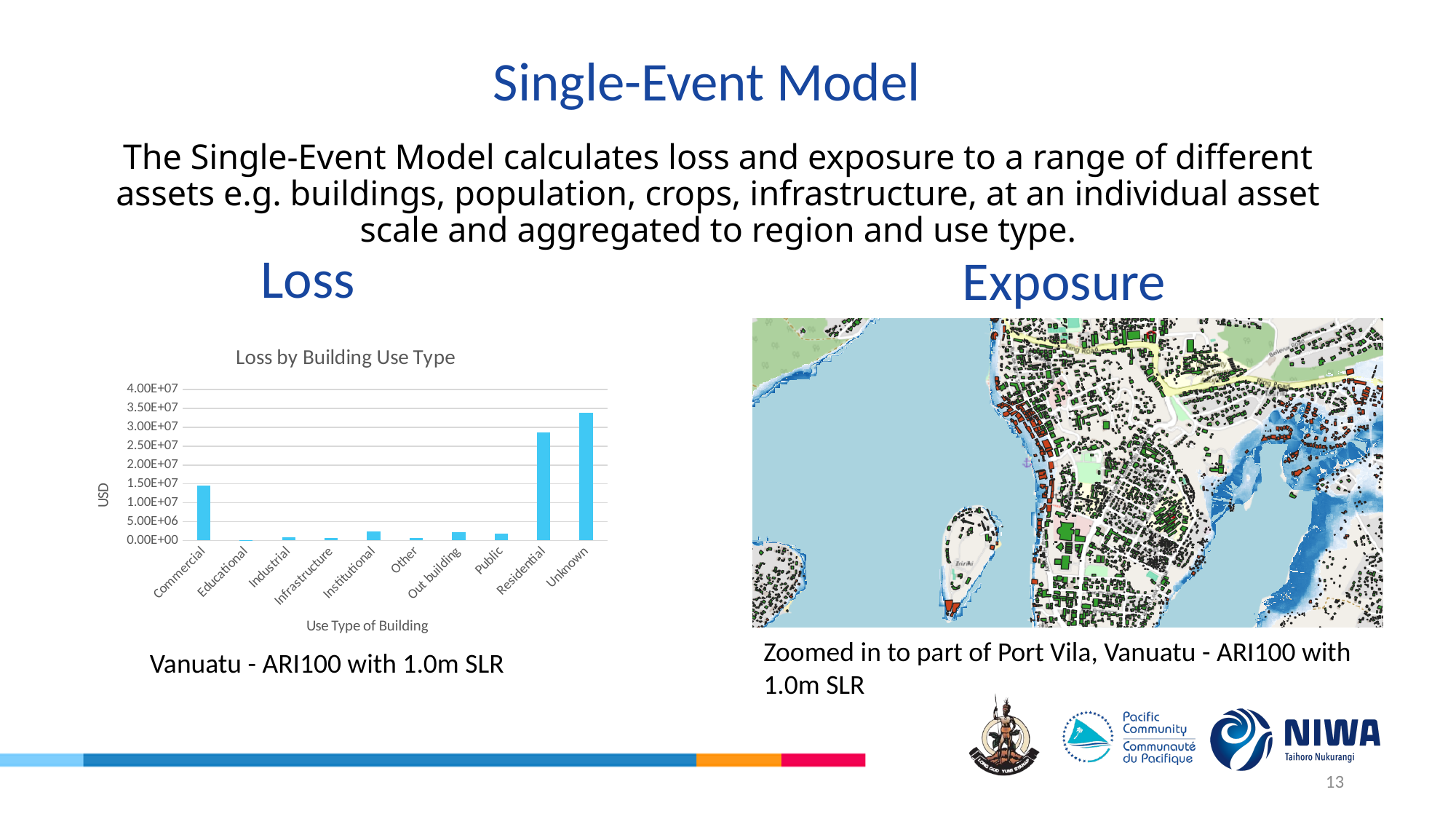
How many building use type categories are shown on the x axis of the "Loss by Building Use Type" chart? 10 What is the label on the y axis of the "Loss by Building Use Type" chart? USD In the "Loss by Building Use Type" chart, which has the larger loss, Residential or Unknown? Unknown What is the label on the x axis of the "Loss by Building Use Type" chart? Use Type of Building Is the loss for Institutional in the "Loss by Building Use Type" chart greater or less than 5.00E+06? less In the "Loss by Building Use Type" chart, which has the larger loss, Commercial or Residential? Residential Is the loss for Residential in the "Loss by Building Use Type" chart greater or less than 2.50E+07? greater Is the loss for Commercial in the "Loss by Building Use Type" chart greater or less than 1.00E+07? greater What kind of chart is "Loss by Building Use Type"? bar chart Which building use type has the highest loss in the "Loss by Building Use Type" chart? Unknown